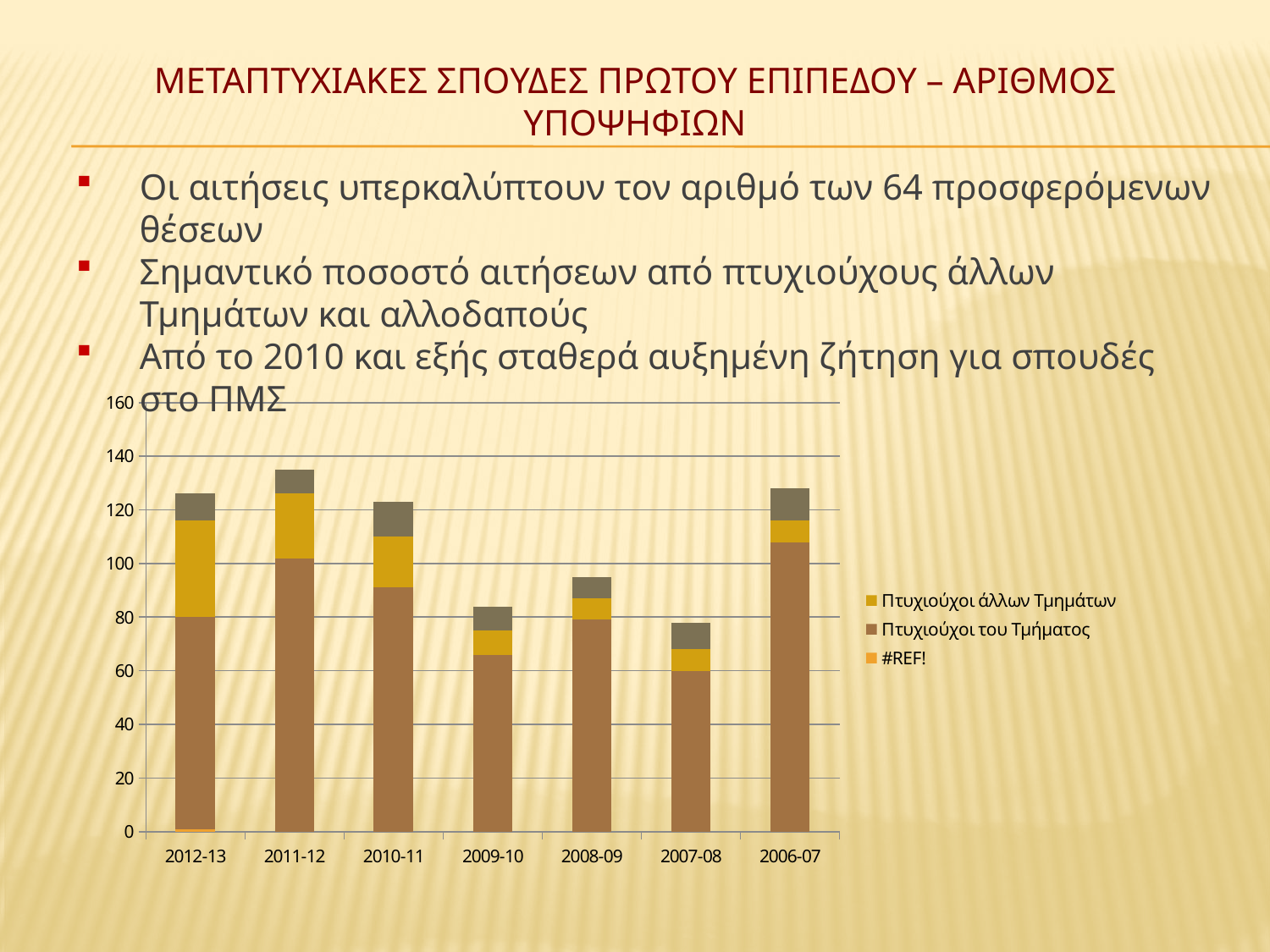
How many series does the chart's legend list? 3 What is the third entry listed in the chart's legend? #REF! Which academic year has the tallest stacked bar in the chart? 2011-12 What kind of chart is shown on the slide? stacked bar chart Is the Πτυχιούχοι του Τμήματος segment for 2006-07 greater or less than 100? greater Which bar is taller in total, 2011-12 or 2007-08? 2011-12 Is the total height of the bar for 2007-08 greater or less than 100? less Which academic year has the shortest stacked bar in the chart? 2007-08 How many academic-year categories are shown on the x axis of the chart? 7 Is the total height of the bar for 2011-12 greater or less than 120? greater Which bar is taller in total, 2008-09 or 2009-10? 2008-09